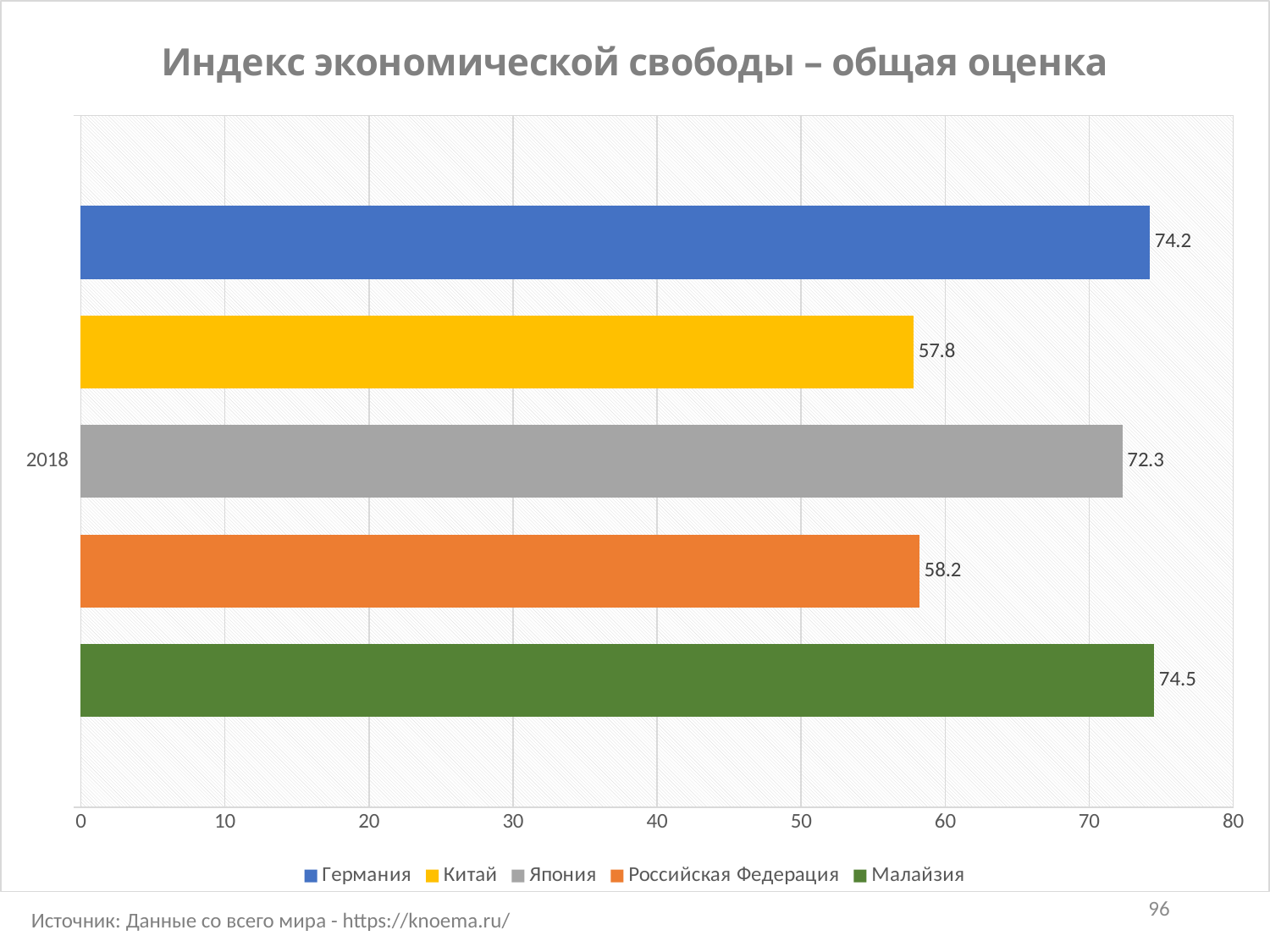
Which country has the highest value on the chart? Малайзия What is the value for Япония in 2018? 72.3 What is the value for Малайзия in 2018? 74.5 What is the value for Германия in 2018? 74.2 What is the value for Китай in 2018? 57.8 How many series does the legend list? 5 Which country has the lowest value on the chart? Китай What is the title of the chart? Индекс экономической свободы – общая оценка What kind of chart is shown on the slide? Bar chart What is the value for Российская Федерация in 2018? 58.2 Which is larger, the value for Российская Федерация or the value for Китай? Российская Федерация What is the difference between the values for Германия and Япония? 1.9